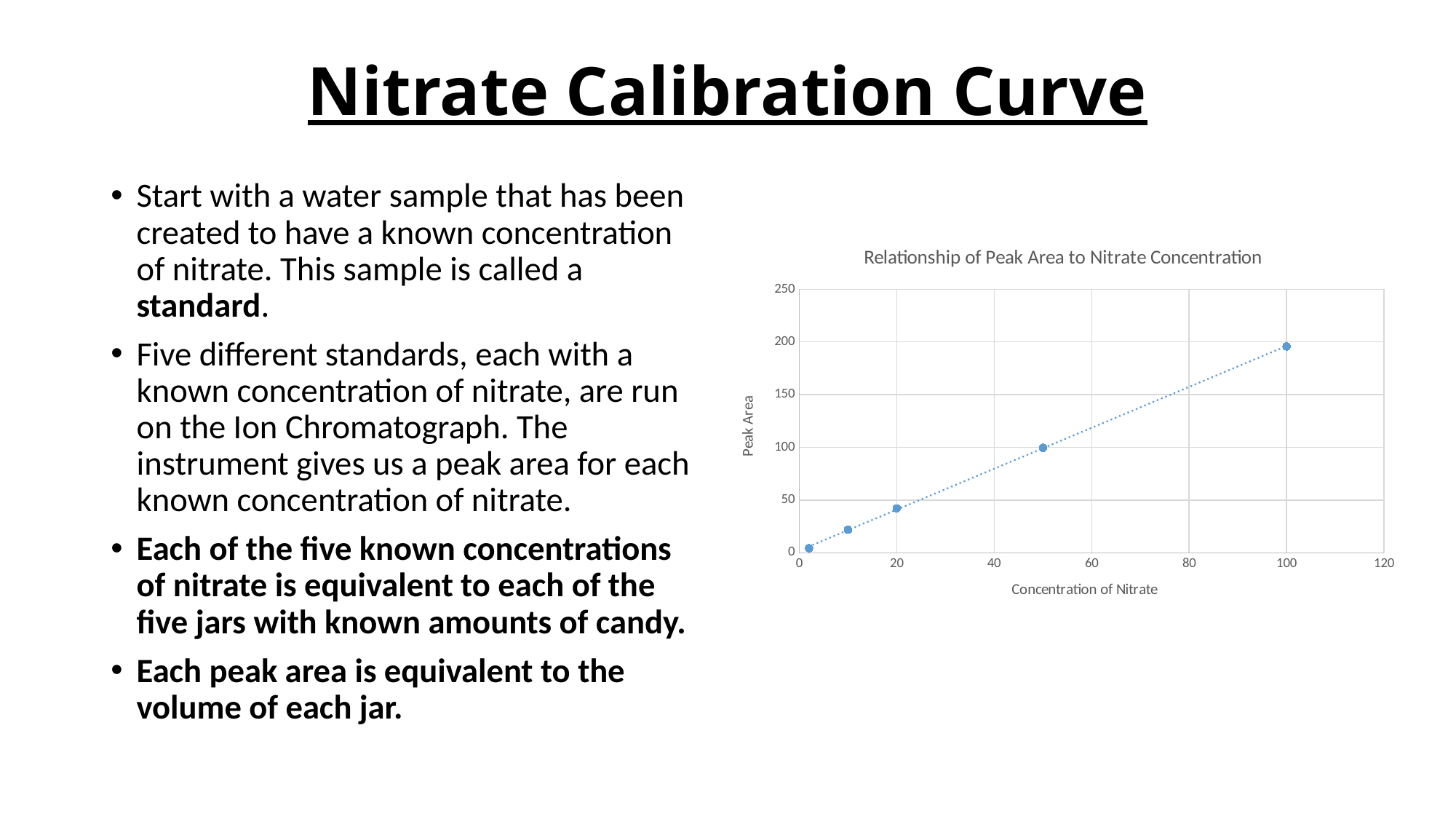
Which plotted point has the highest peak area? The point at a nitrate concentration of 100 How many data points are plotted in the chart? 5 Is the peak area for the point at a nitrate concentration of 20 greater or less than 50? less Is the peak area for the point at a nitrate concentration of 50 greater or less than 150? less What is the label of the vertical axis of the chart? Peak Area Is the peak area for the point at a nitrate concentration of 10 greater or less than 50? less What is the title of the chart? Relationship of Peak Area to Nitrate Concentration What kind of chart is shown on the slide? Scatter plot Does peak area rise or fall as the concentration of nitrate increases? Rises Which has the larger peak area: the point at a nitrate concentration of 20 or the point at 50? The point at 50